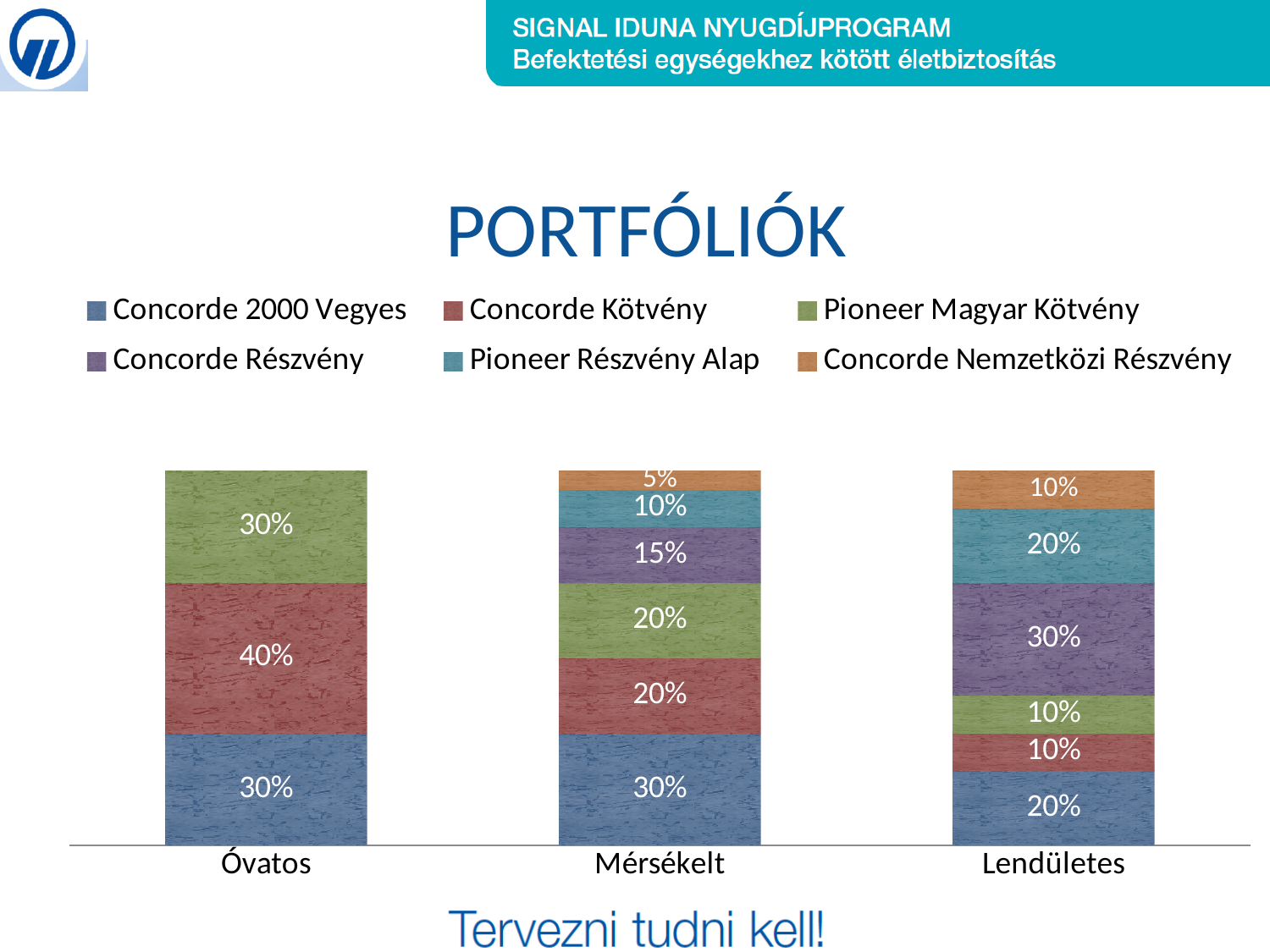
What is the value for Pioneer Részvény Alap in the Lendületes portfolio? 20% Which series has the largest share in the Óvatos portfolio? Concorde Kötvény What is the difference between the Concorde Kötvény value in Óvatos and in Lendületes? 30% Which series has the smallest share in the Mérsékelt portfolio? Concorde Nemzetközi Részvény What is the value for Concorde Részvény in the Lendületes portfolio? 30% What is the value for Concorde 2000 Vegyes in the Mérsékelt portfolio? 30% How many series does the legend list? 6 What is the value for Concorde Kötvény in the Óvatos portfolio? 40% What is the value for Concorde Nemzetközi Részvény in the Mérsékelt portfolio? 5% How many portfolio categories are shown on the x axis? 3 What kind of chart is shown on the slide? Stacked bar chart Which is larger: Concorde Részvény in Mérsékelt or Concorde Részvény in Lendületes? Concorde Részvény in Lendületes